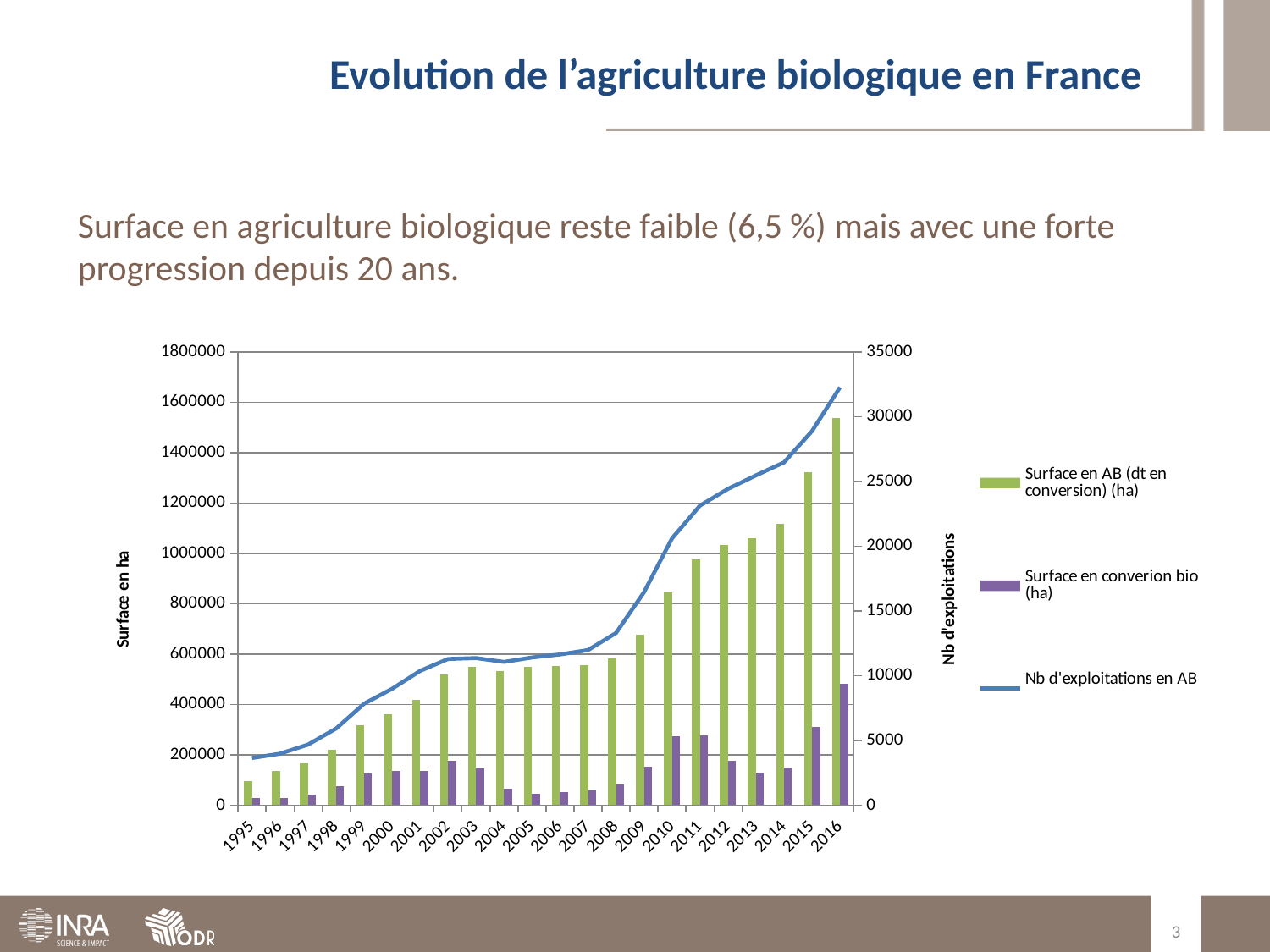
Does the Nb d'exploitations en AB line generally rise or fall from 1995 to 2016? Rise Is the value for Surface en AB (dt en conversion) (ha) in 2016 greater or less than 1400000? greater In which year is the Surface en AB (dt en conversion) (ha) lowest? 1995 What is the title of the left vertical axis? Surface en ha Is the value for Surface en converion bio (ha) in 2016 greater or less than 400000? greater Is the value for Nb d'exploitations en AB in 1995 greater or less than 5000? less How many years are shown on the x axis of the chart? 22 What kind of chart is shown on the slide? A combined bar and line chart In which year is the Surface en AB (dt en conversion) (ha) highest? 2016 What is the title of the right vertical axis? Nb d'exploitations Which year has the larger Surface en converion bio (ha), 2010 or 2012? 2010 How many series does the chart legend list? 3